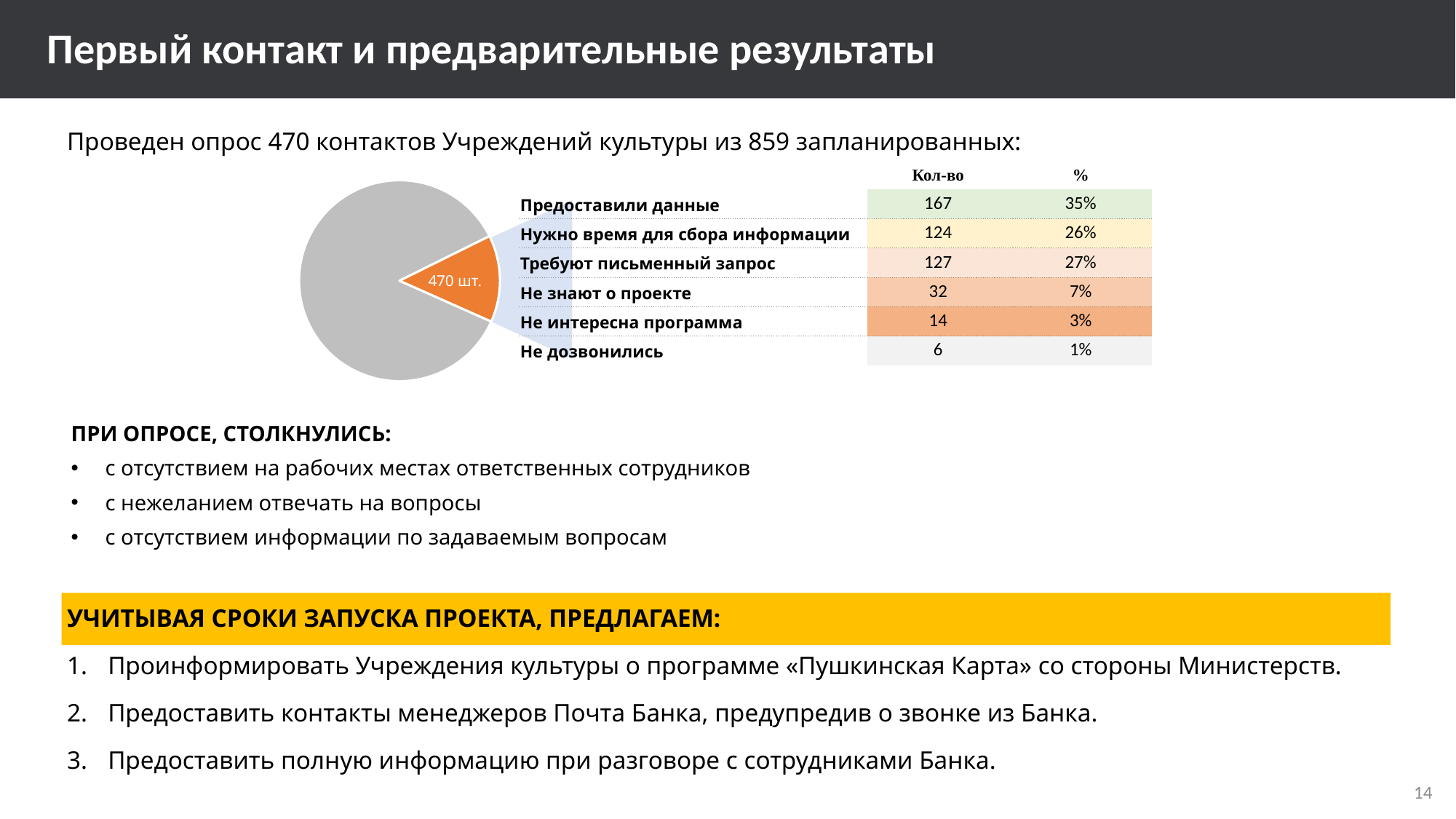
What value is printed on the orange slice of the pie chart? 470 шт. In the breakdown of the pie chart's orange slice, what percentage is shown for 'Требуют письменный запрос'? 27% In the breakdown of the pie chart's orange slice, what percentage is shown for 'Не дозвонились'? 1% In the breakdown of the pie chart's orange slice, which has a higher count: 'Не знают о проекте' or 'Не интересна программа'? Не знают о проекте What kind of chart is shown on the slide? pie chart In the breakdown of the pie chart's orange slice, which category has the lowest count? Не дозвонились How many slices does the pie chart have? 2 In the breakdown of the pie chart's orange slice, how many contacts are listed for 'Предоставили данные'? 167 In the breakdown of the pie chart's orange slice, which category has the highest count? Предоставили данные How many categories are listed in the breakdown of the pie chart's orange slice? 6 In the breakdown of the pie chart's orange slice, what is the difference in count between 'Предоставили данные' and 'Нужно время для сбора информации'? 43 Which slice of the pie chart is larger, the grey one or the orange one? the grey one